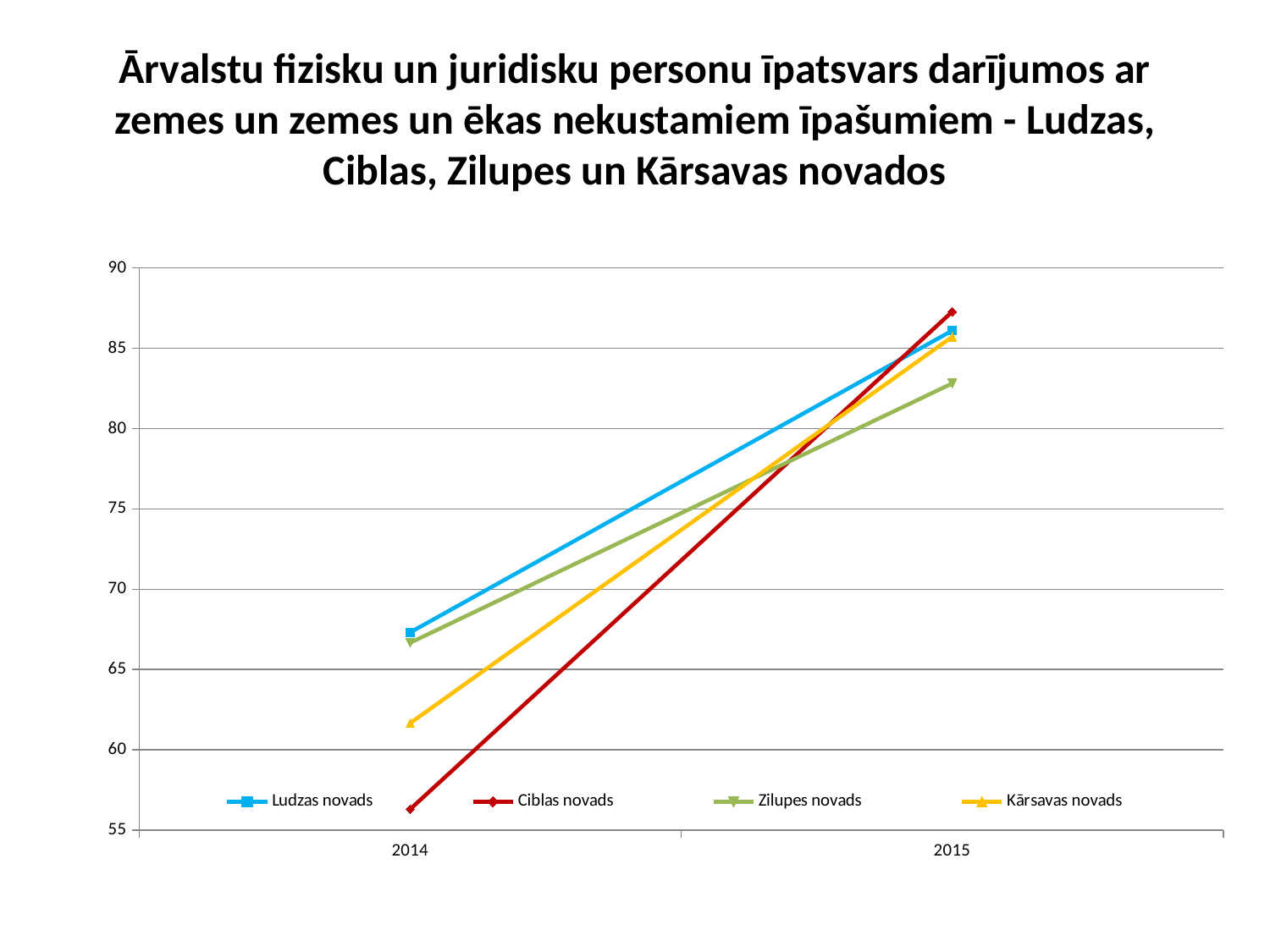
What kind of chart is shown on the slide? line chart Does the value for Ciblas novads rise or fall from 2014 to 2015? rise Which series has the lowest value in 2015? Zilupes novads Is the value for Kārsavas novads in 2014 greater or less than 60? greater Is the value for Ciblas novads in 2014 greater or less than 60? less Which series has the lowest value in 2014? Ciblas novads Is the value for Zilupes novads in 2015 greater or less than 85? less How many years are shown on the x axis? 2 How many series does the legend list? 4 Which series is drawn in red? Ciblas novads In 2014, which is larger: the value for Ludzas novads or Kārsavas novads? Ludzas novads